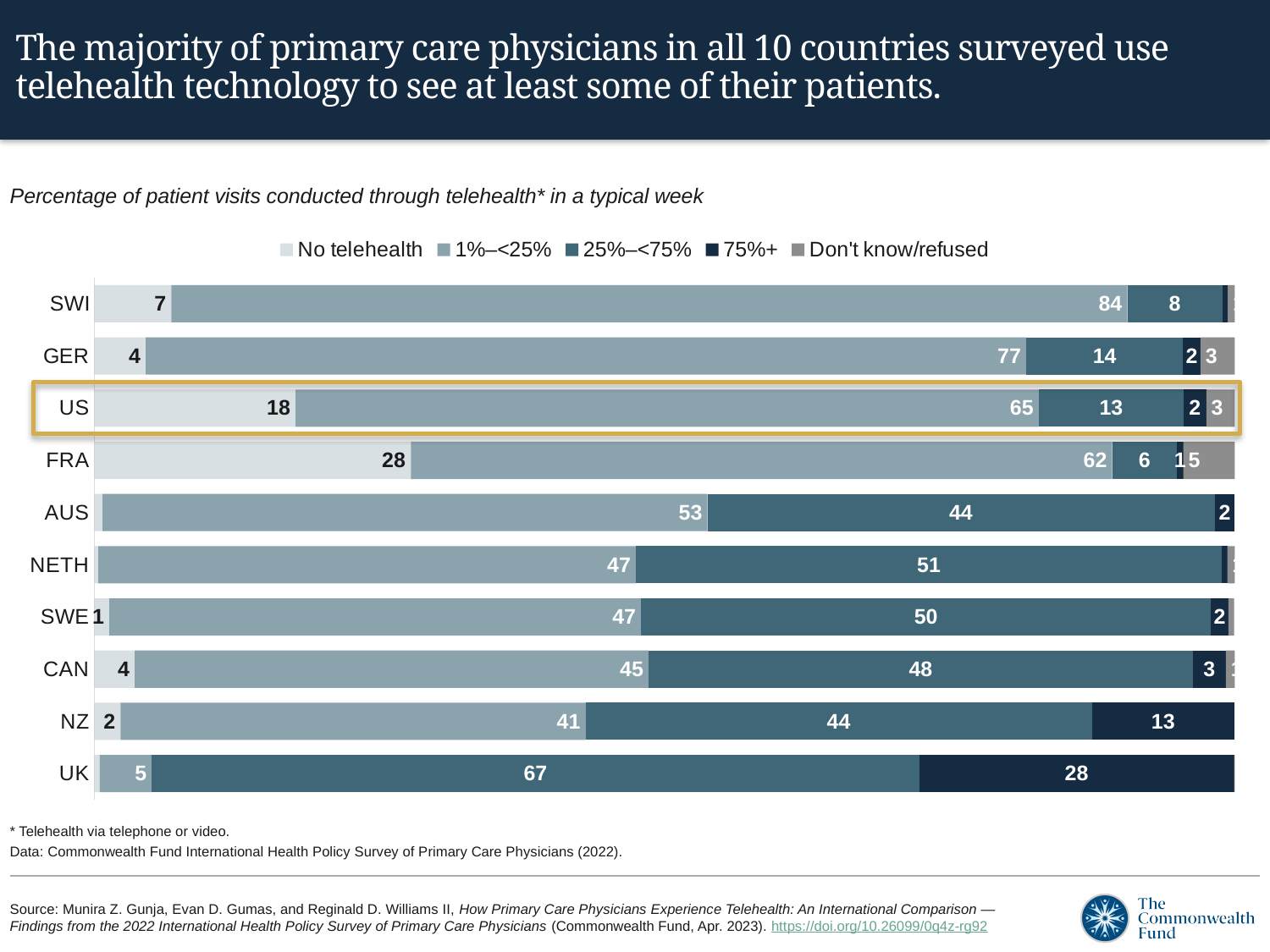
How many countries are shown on the chart? 10 What is the value for '25%–<75%' for NETH? 51 What is the value for '75%+' for the UK? 28 What kind of chart is shown on the slide? Stacked bar chart How many series does the legend list? 5 Which is larger, the '1%–<25%' value for GER or for FRA? GER Which country has the highest value for '75%+'? UK Which country has the highest value for 'No telehealth'? FRA What percentage of physicians in SWI conduct 1%–<25% of patient visits through telehealth? 84 Which country has the highest value for '1%–<25%'? SWI What is the value for 'No telehealth' for the US? 18 What is the difference between the '25%–<75%' values for NZ and the US? 31